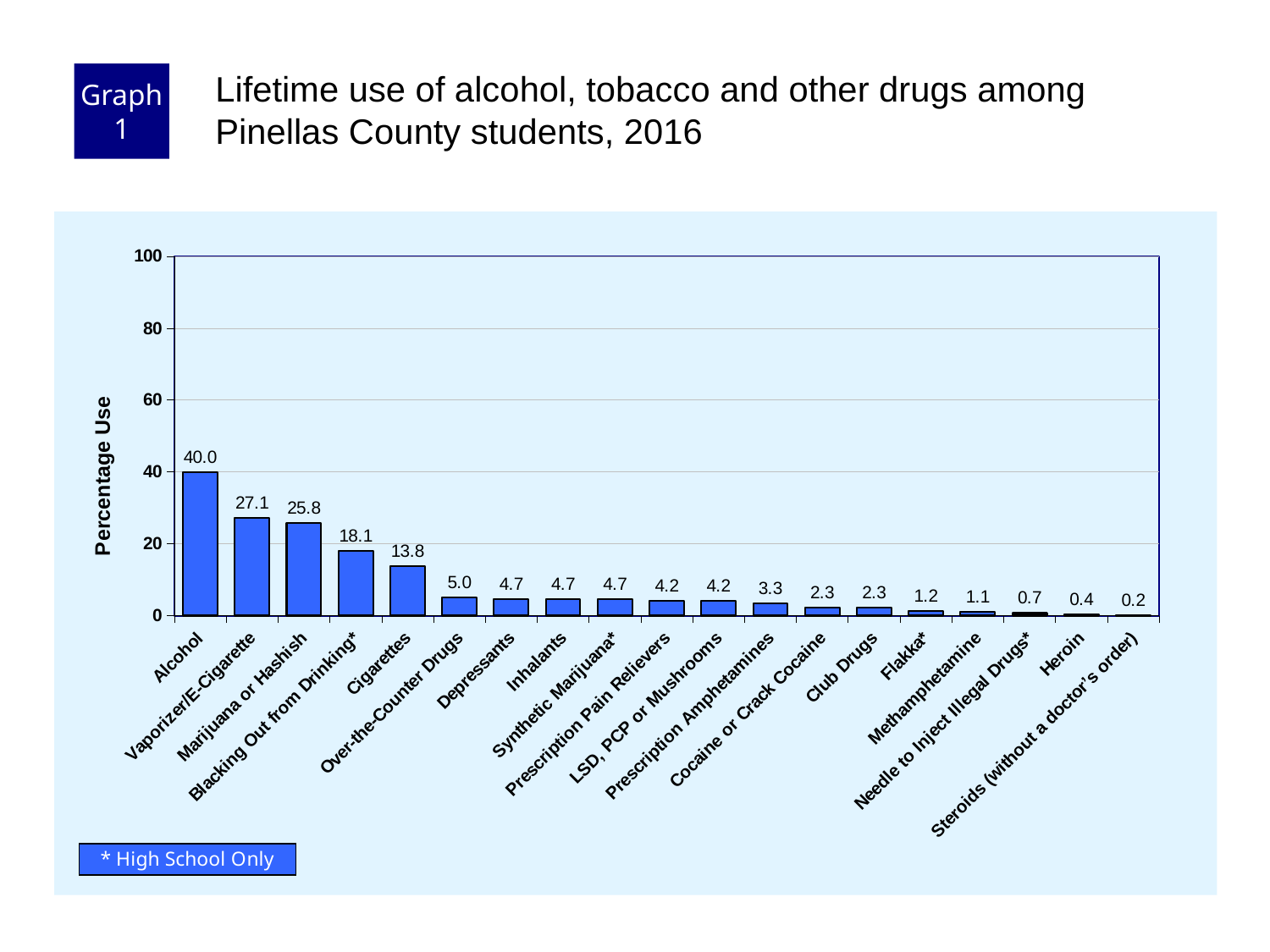
How many categories are shown on the chart? 19 What is the percentage use for Alcohol? 40.0 What is the label of the y axis? Percentage Use Do the values rise or fall moving from left to right along the x axis? Fall What kind of chart is shown on the slide? Bar chart What is the percentage use for Heroin? 0.4 What is the percentage use for Cigarettes? 13.8 What is the percentage use for Vaporizer/E-Cigarette? 27.1 Which category has the lowest percentage use? Steroids (without a doctor's order) Which category has the highest percentage use? Alcohol What is the difference in percentage use between Alcohol and Marijuana or Hashish? 14.2 Which has a higher percentage use, Blacking Out from Drinking* or Cigarettes? Blacking Out from Drinking*